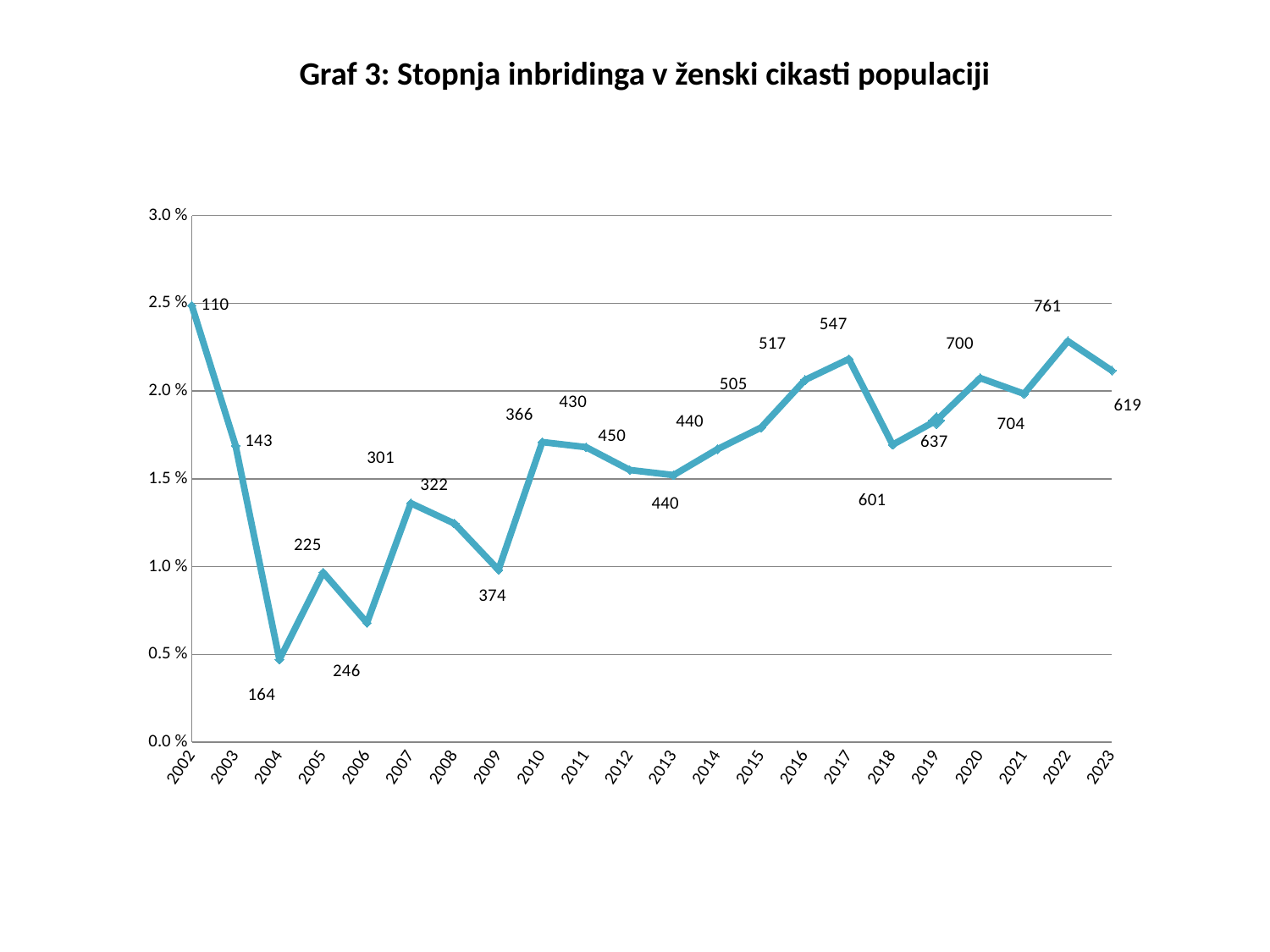
Which year has the highest value on the chart? 2002 Is the value for 2002 greater or less than 2.0 %? greater Which year has the lowest value on the chart? 2004 What data label is printed next to the point for 2022? 761 How many years are shown along the x axis of the chart? 22 Is the value for 2004 greater or less than 1.0 %? less Is the value for 2022 greater or less than 2.0 %? greater Does the line rise or fall from 2002 to 2004? fall What is the title of the chart? Graf 3: Stopnja inbridinga v ženski cikasti populaciji What kind of chart is shown on the slide? line chart Which year has the larger value, 2016 or 2018? 2016